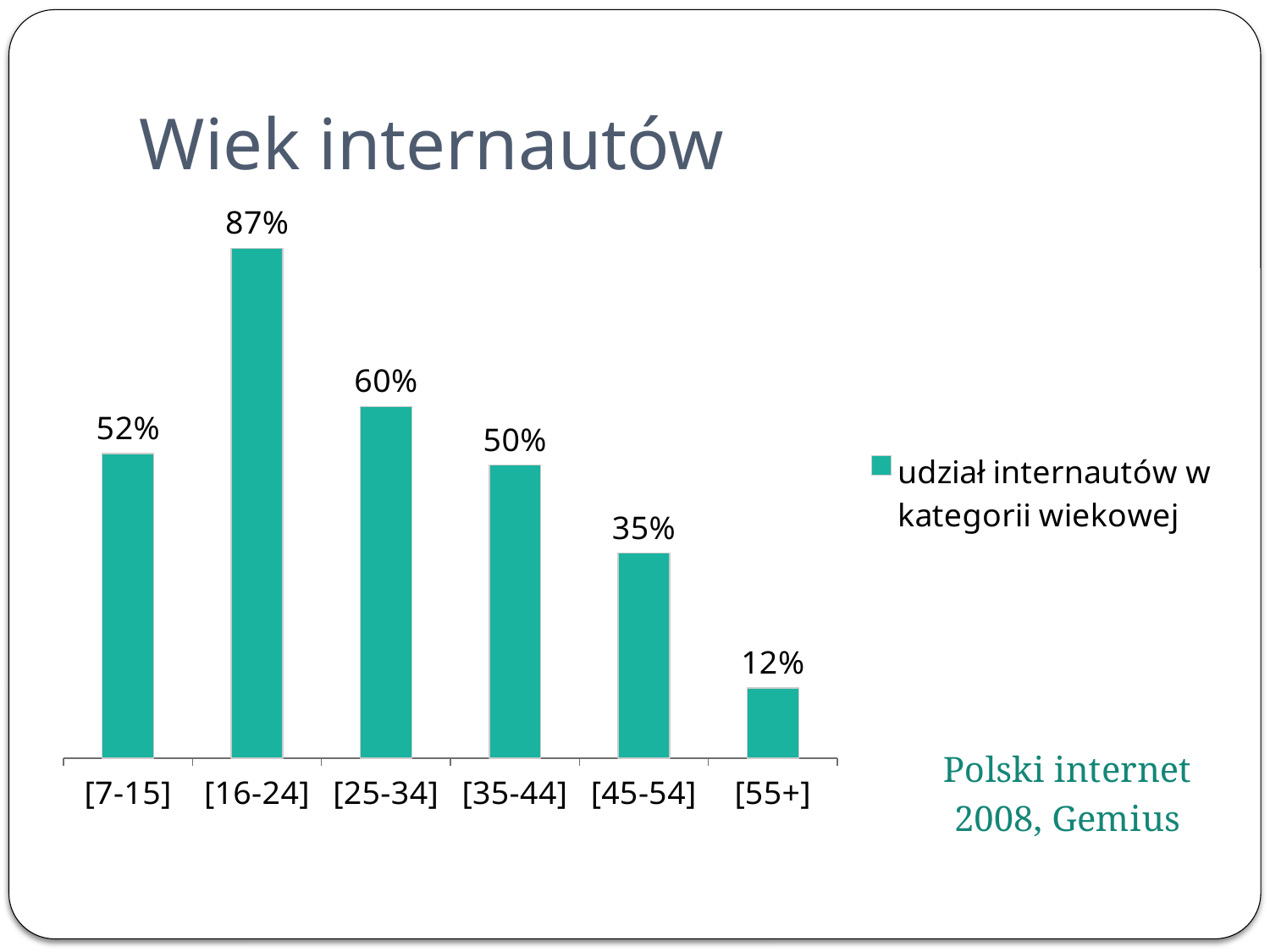
What kind of chart is shown on the slide? bar chart Which is larger, the value for [7-15] or the value for [45-54]? [7-15] Which age group has the highest value? [16-24] What is the value for the [16-24] age group? 87% How many age groups are shown on the chart? 6 How many series does the legend list? 1 What is the title of the chart? Wiek internautów What is the value for the [35-44] age group? 50% What is the value for the [55+] age group? 12% What is the difference between the values for [7-15] and [55+]? 40% What is the difference between the values for [16-24] and [25-34]? 27% Which age group has the lowest value? [55+]